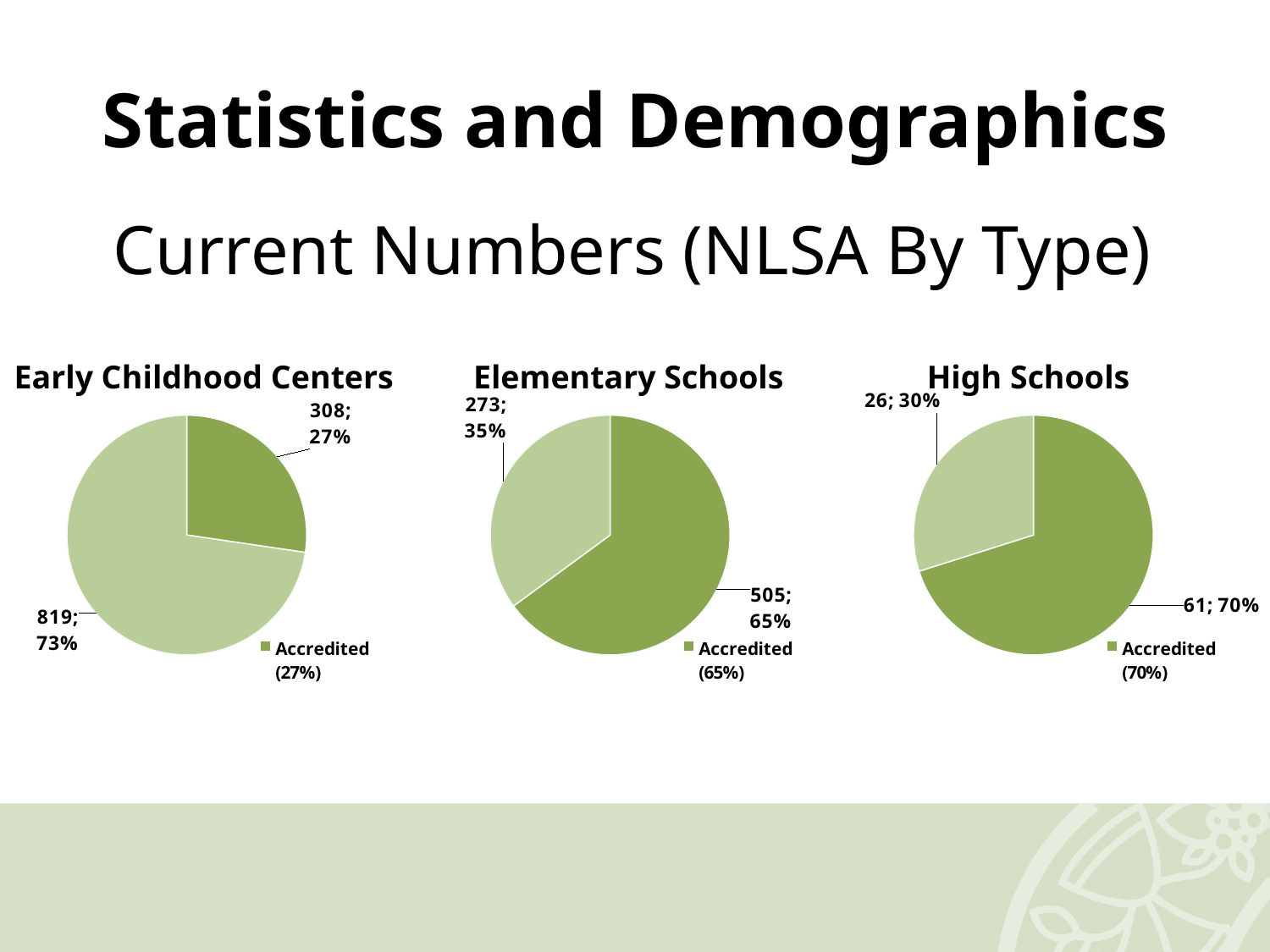
What kind of chart is used for the Elementary Schools data? Pie chart In the Elementary Schools chart, what is the difference between the two slice values? 232 In the Elementary Schools chart, what share of the pie is the Accredited slice? 65% In the Early Childhood Centers chart, which slice is the largest? 819; 73% In the High Schools chart, which slice is larger, the one labeled 61 or the one labeled 26? 61 In the Elementary Schools chart, how many schools are accredited? 505 In the High Schools chart, how many schools are accredited? 61 How many slices does the High Schools pie chart have? 2 In the Early Childhood Centers chart, what share of the pie is the Accredited slice? 27% In the Early Childhood Centers chart, how many centers are accredited? 308 In the Early Childhood Centers chart, what is the total of the two slices? 1127 In the High Schools chart, what share of the pie is the slice labeled 26? 30%